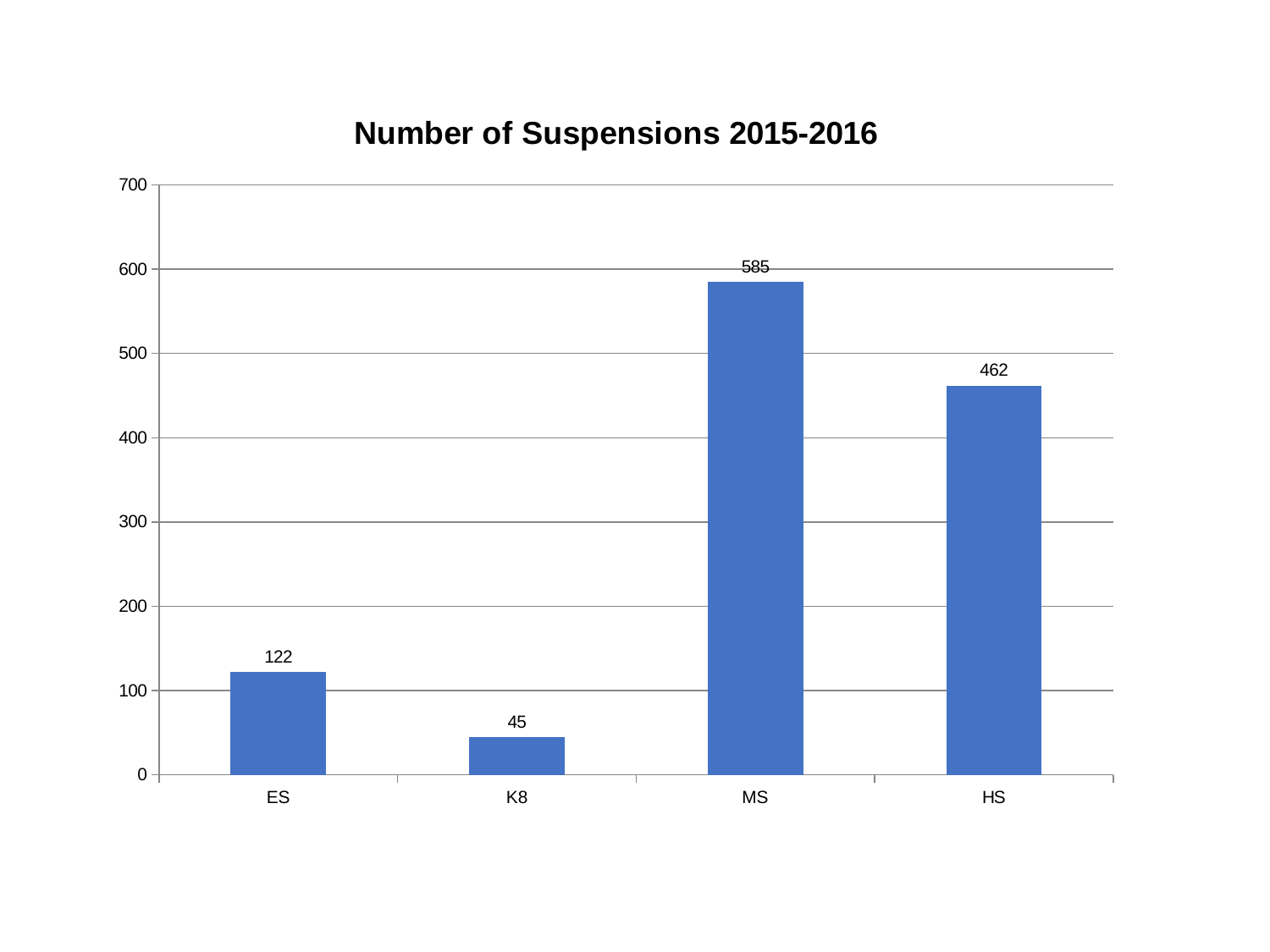
How many categories are shown on the x axis? 4 What is the number of suspensions for MS? 585 Which category has the lowest number of suspensions? K8 What is the difference in suspensions between MS and HS? 123 What type of chart is shown on the slide? Bar chart What is the number of suspensions for HS? 462 Which category has the highest number of suspensions? MS What is the number of suspensions for K8? 45 Which has more suspensions, ES or HS? HS Is the value for HS greater or less than 400? greater What is the difference in suspensions between ES and K8? 77 What is the number of suspensions for ES? 122